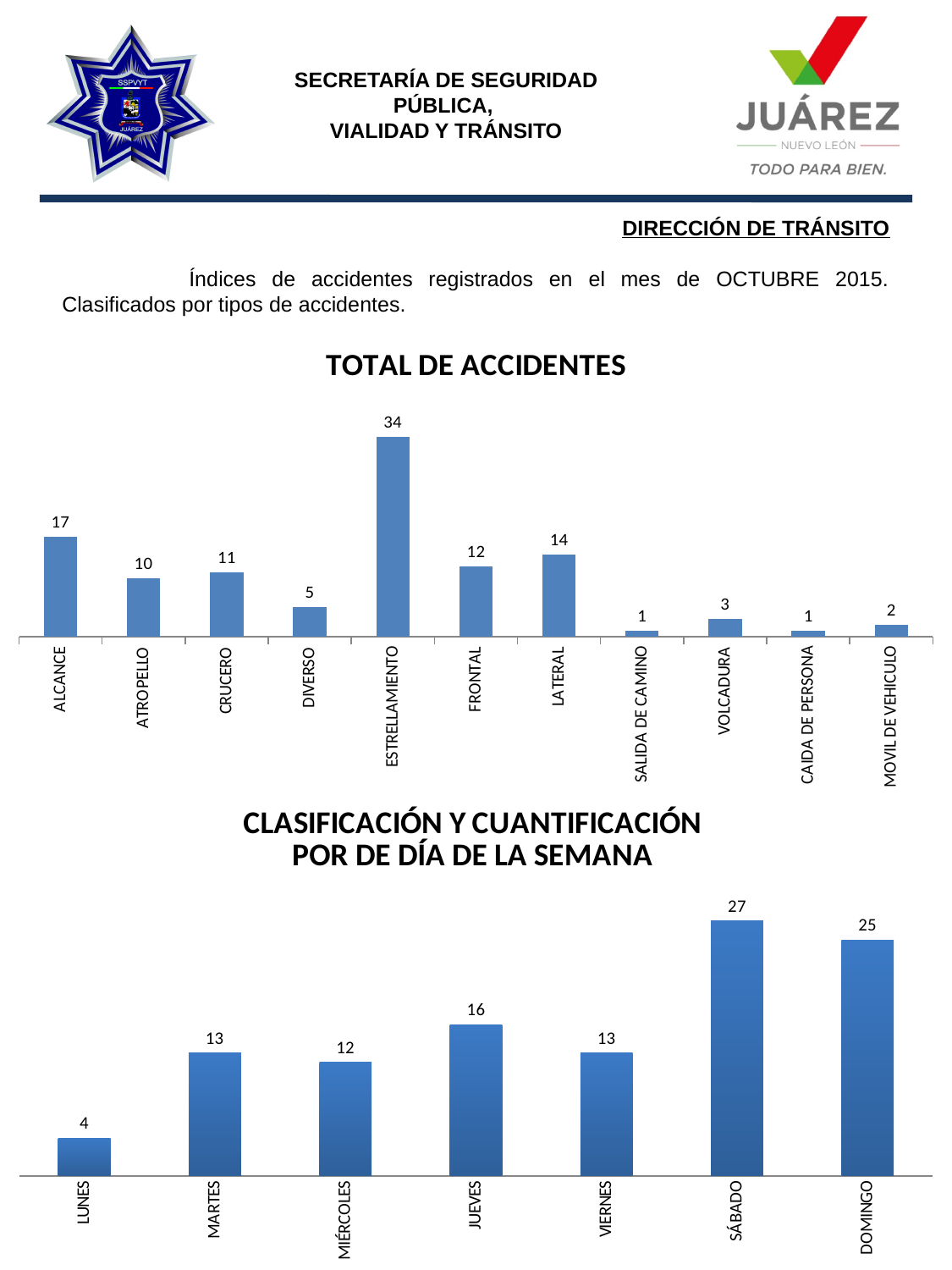
In the 'CLASIFICACIÓN Y CUANTIFICACIÓN POR DE DÍA DE LA SEMANA' chart, which day has the lowest value? LUNES In the 'TOTAL DE ACCIDENTES' chart, what is the value for ESTRELLAMIENTO? 34 In the 'CLASIFICACIÓN Y CUANTIFICACIÓN POR DE DÍA DE LA SEMANA' chart, what is the value for SÁBADO? 27 In the 'CLASIFICACIÓN Y CUANTIFICACIÓN POR DE DÍA DE LA SEMANA' chart, what is the difference between SÁBADO and DOMINGO? 2 In the 'TOTAL DE ACCIDENTES' chart, what is the difference between ALCANCE and ATROPELLO? 7 In the 'TOTAL DE ACCIDENTES' chart, what is the value for VOLCADURA? 3 In the 'TOTAL DE ACCIDENTES' chart, how many categories are shown on the x axis? 11 In the 'TOTAL DE ACCIDENTES' chart, which category has the highest value? ESTRELLAMIENTO What kind of chart is the 'CLASIFICACIÓN Y CUANTIFICACIÓN POR DE DÍA DE LA SEMANA' chart? Bar chart In the 'CLASIFICACIÓN Y CUANTIFICACIÓN POR DE DÍA DE LA SEMANA' chart, what is the value for JUEVES? 16 In the 'CLASIFICACIÓN Y CUANTIFICACIÓN POR DE DÍA DE LA SEMANA' chart, how many days are shown? 7 In the 'TOTAL DE ACCIDENTES' chart, which is larger, FRONTAL or LATERAL? LATERAL